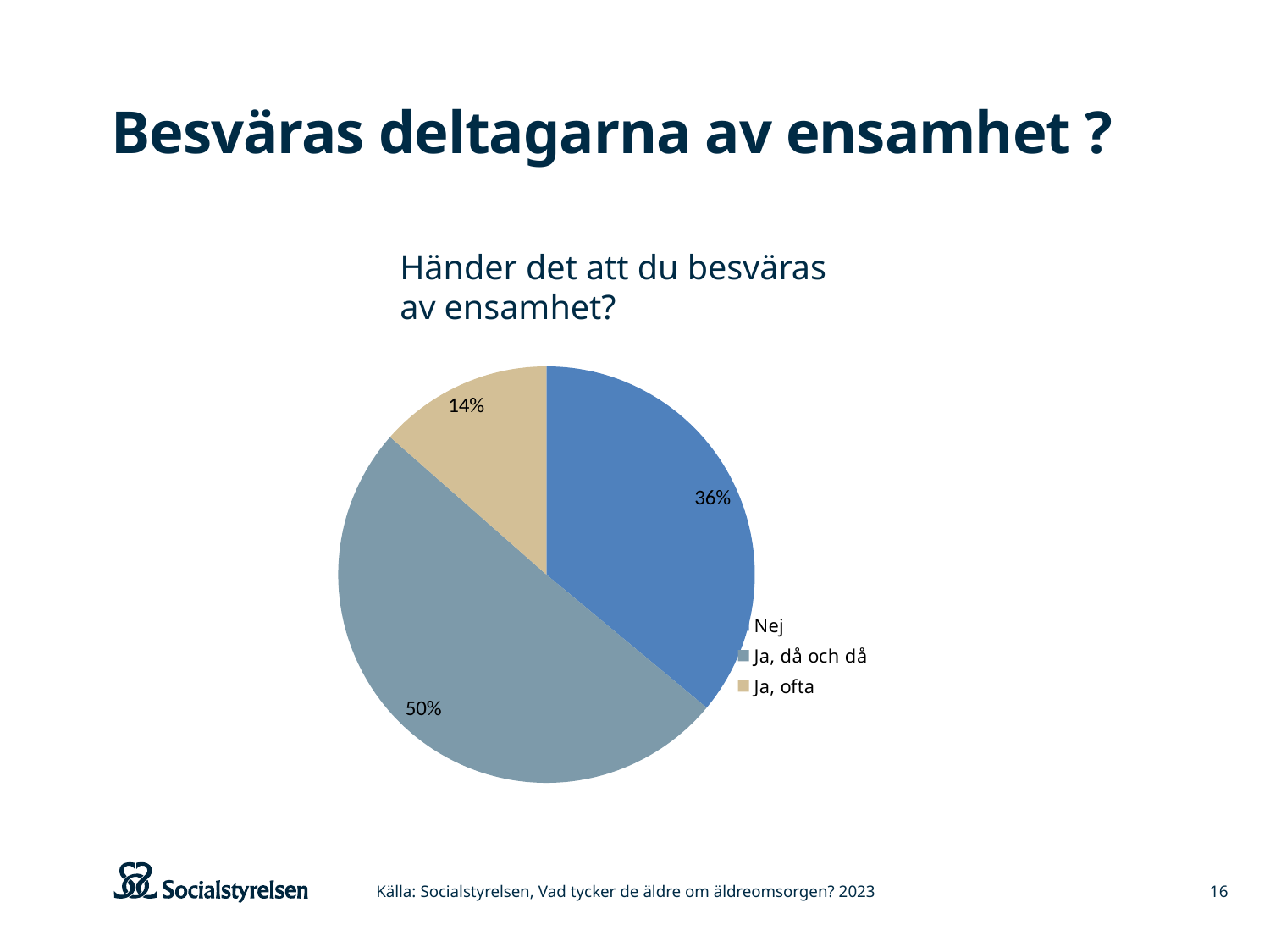
What is the chart's title? Händer det att du besväras av ensamhet? Which category is shown in the beige colour? Ja, ofta What share of the pie is "Ja, då och då"? 50% Which category has the smallest slice? Ja, ofta Which category has the largest slice? Ja, då och då What share of the pie is "Nej"? 36% What is the combined share of the two "Ja" categories? 64% What kind of chart is shown on the slide? pie chart How many categories does the pie chart show? 3 What share of the pie is "Ja, ofta"? 14% Which is larger, the slice for "Nej" or the slice for "Ja, ofta"? Nej What is the difference in percentage points between "Ja, då och då" and "Nej"? 14